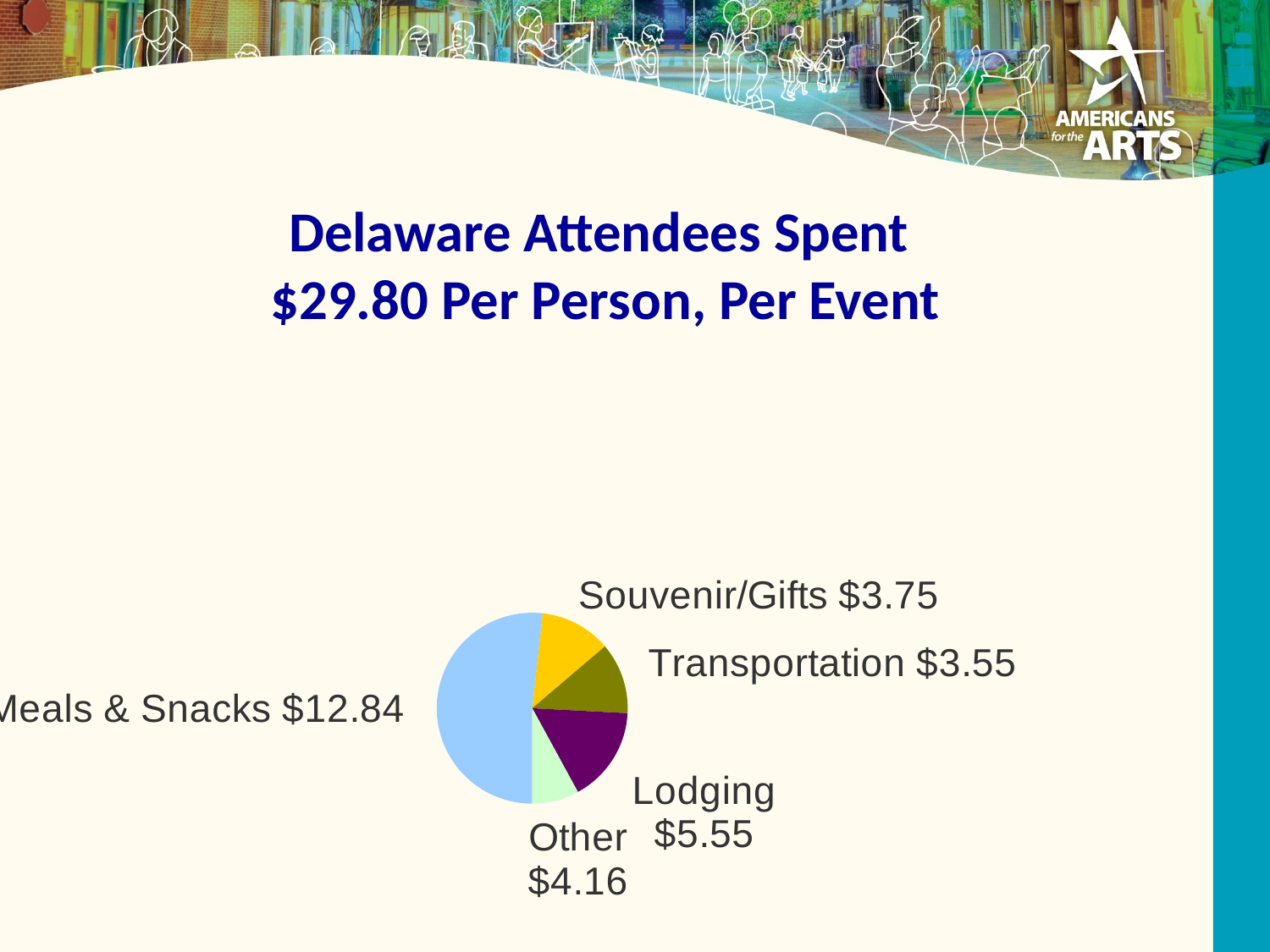
What is the difference between the Meals & Snacks value and the Lodging value? $7.29 What is the difference between the Souvenir/Gifts value and the Transportation value? $0.20 Which spending category has the largest slice of the pie? Meals & Snacks Which is larger, the value for Lodging or the value for Other? Lodging What is the value shown for Transportation? $3.55 How many categories are shown in the pie chart? 5 How much did Delaware attendees spend on Meals & Snacks per person, per event? $12.84 What type of chart is shown on the slide? Pie chart According to the slide title, how much did Delaware attendees spend per person, per event? $29.80 Which spending category has the smallest value? Transportation What is the value shown for Lodging? $5.55 What is the value shown for Souvenir/Gifts? $3.75